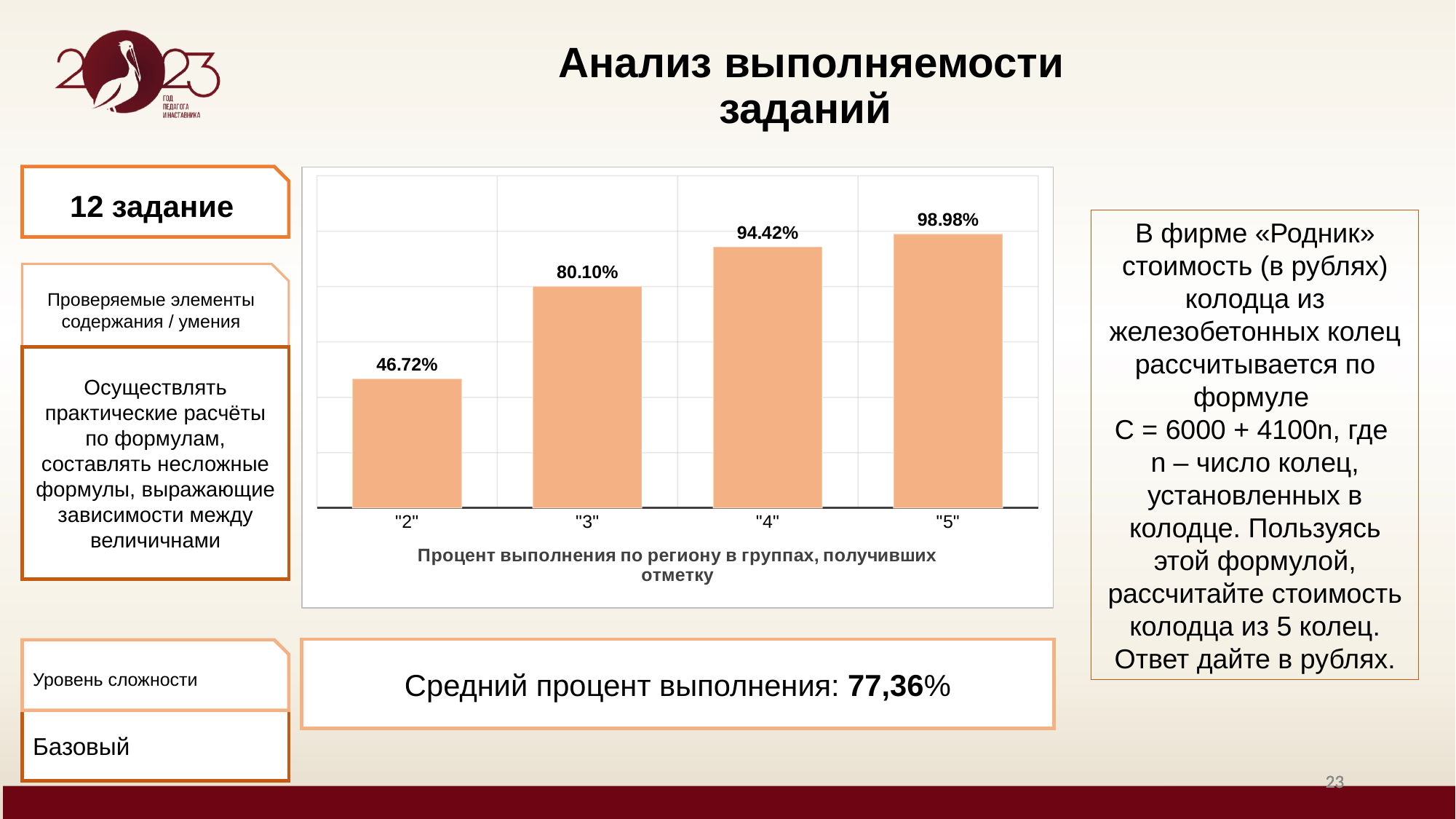
What is the completion percentage for the group with mark "3"? 80.10% What is the completion percentage for the group with mark "5"? 98.98% Which group has the highest completion percentage? "5" Which group has the lowest completion percentage? "2" Which group has a higher completion percentage, "3" or "4"? "4" Do the completion percentages rise or fall as the mark increases from "2" to "5"? Rise What is the completion percentage for the group with mark "2"? 46.72% What type of chart is shown on the slide? Bar chart What is the difference between the completion percentages of groups "3" and "2"? 33.38% How many groups (categories) are shown in the chart? 4 What is the completion percentage for the group with mark "4"? 94.42% What is the difference between the completion percentages of groups "5" and "4"? 4.56%